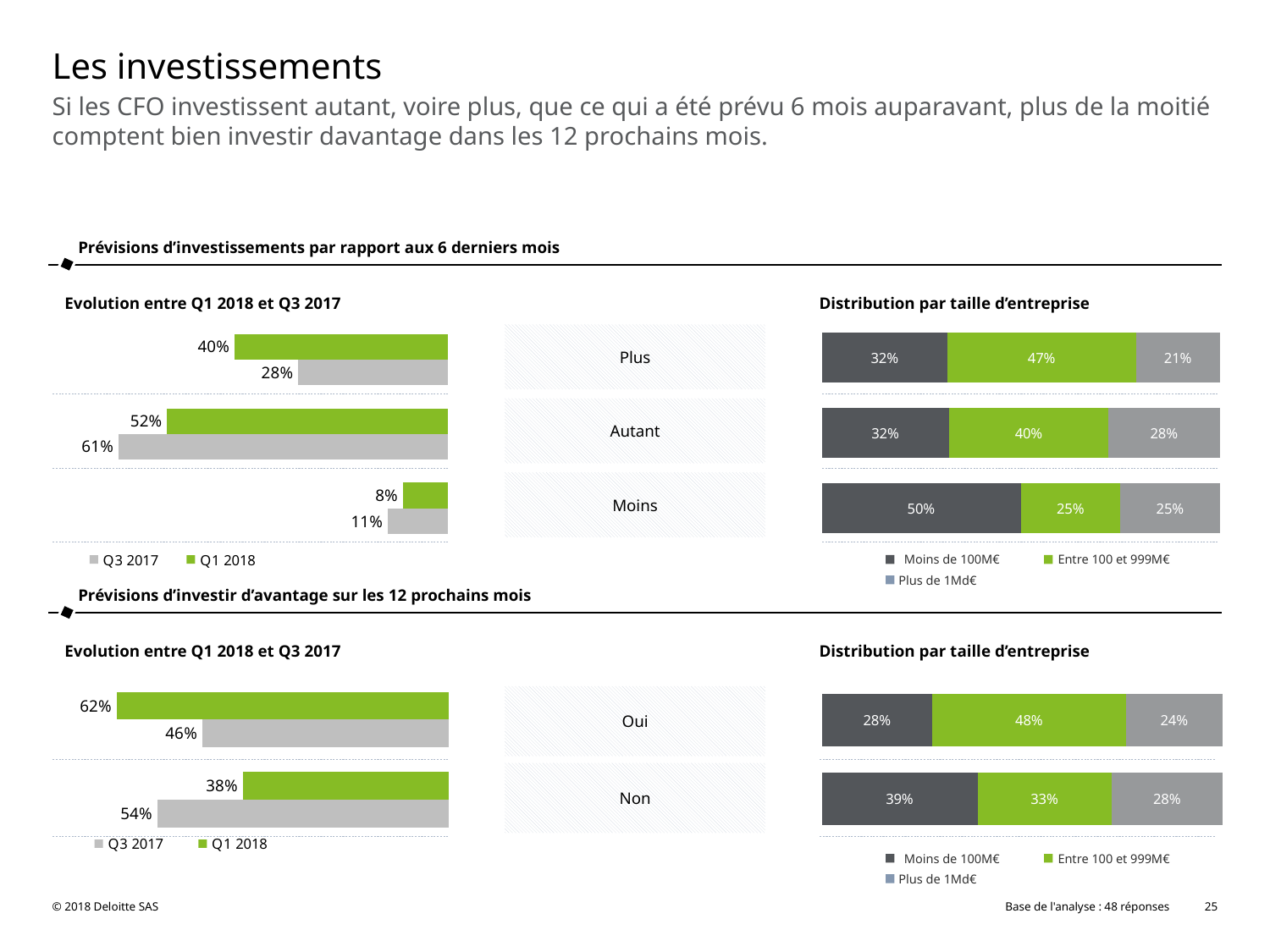
How many categories are shown in the bottom-left chart (Evolution entre Q1 2018 et Q3 2017, 12 prochains mois)? 2 In the top-left chart (Evolution entre Q1 2018 et Q3 2017, 6 derniers mois), what is the Q1 2018 value for Plus? 40% How many series does the legend of the top-right chart (Distribution par taille d'entreprise, 6 derniers mois) list? 3 In the top-right chart (Distribution par taille d'entreprise, 6 derniers mois), what is the Moins de 100M€ share for Moins? 50% In the bottom-left chart (Evolution entre Q1 2018 et Q3 2017, 12 prochains mois), which is larger for Non: the Q3 2017 value or the Q1 2018 value? Q3 2017 What type of chart is the bottom-right chart (Distribution par taille d'entreprise, 12 prochains mois)? Stacked bar chart In the top-left chart (Evolution entre Q1 2018 et Q3 2017, 6 derniers mois), what is the difference between the Q1 2018 and Q3 2017 values for Plus? 12% In the bottom-left chart (Evolution entre Q1 2018 et Q3 2017, 12 prochains mois), what is the Q1 2018 value for Oui? 62% In the top-right chart (Distribution par taille d'entreprise, 6 derniers mois), what is the Entre 100 et 999M€ share for Plus? 47% In the top-left chart (Evolution entre Q1 2018 et Q3 2017, 6 derniers mois), which category has the lowest Q1 2018 value? Moins In the bottom-right chart (Distribution par taille d'entreprise, 12 prochains mois), what is the Plus de 1Md€ share for Non? 28% In the top-left chart (Evolution entre Q1 2018 et Q3 2017, 6 derniers mois), what is the Q3 2017 value for Autant? 61%